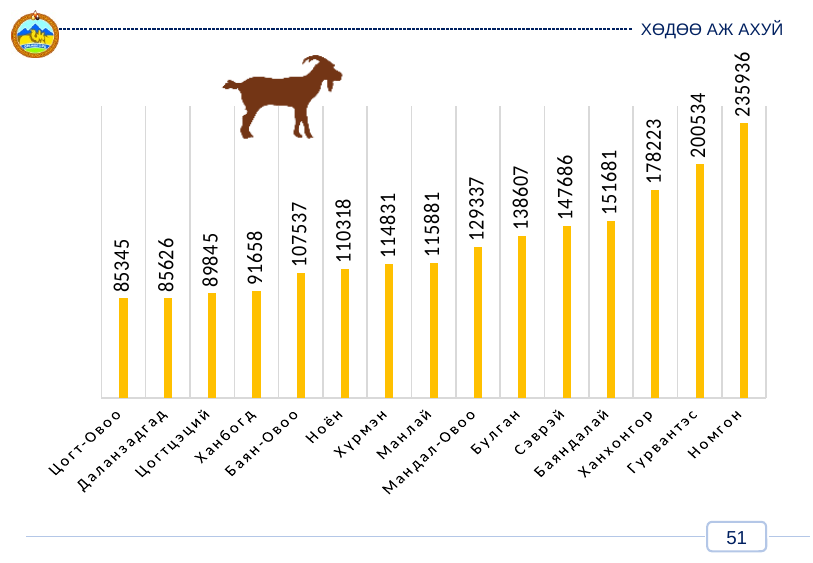
What is the difference between the values for Ханхонгор and Баяндалай? 26542 Which category has the lowest value? Цогт-Овоо What kind of chart is shown on the slide? Bar chart Which category has the highest value? Номгон What is the value for Номгон? 235936 What is the value for Ханбогд? 91658 Which is larger, the value for Булган or the value for Манлай? Булган What is the value for Мандал-Овоо? 129337 Do the values rise or fall from left to right along the x axis? Rise What is the difference between the values for Номгон and Гурвантэс? 35402 What is the value for Сэврэй? 147686 How many categories are shown on the x axis? 15